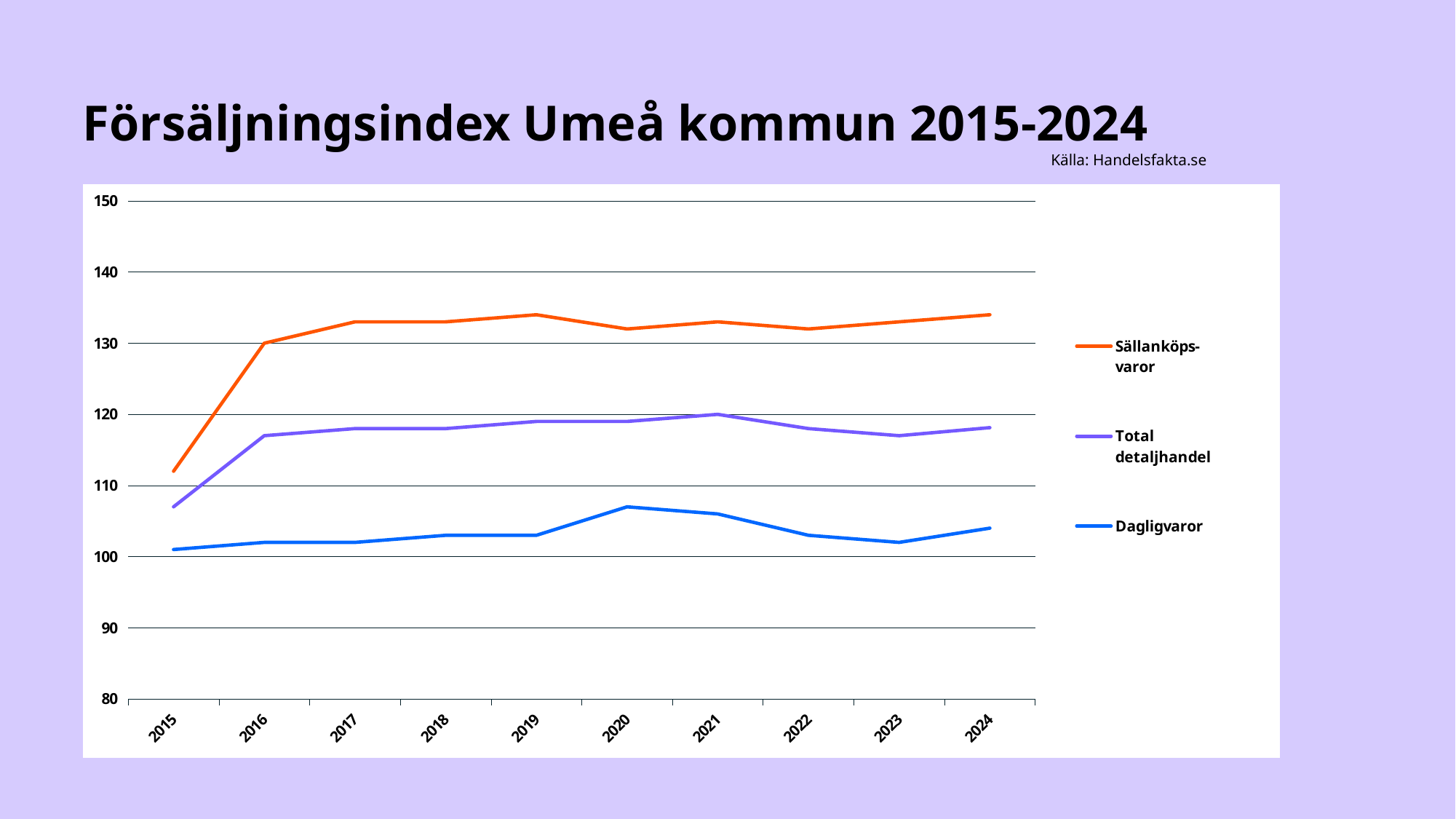
Which series has the lowest values across the whole period? Dagligvaror How many years are plotted along the x axis? 10 Is the value for Sällanköpsvaror in 2024 greater or less than 130? greater What kind of chart is shown on the slide? line chart Which series has the highest values across the whole period? Sällanköpsvaror Is the value for Dagligvaror in 2020 greater or less than 110? less What is the title of the chart? Försäljningsindex Umeå kommun 2015-2024 Is the value for Total detaljhandel in 2015 greater or less than 110? less Which is larger in 2023: Total detaljhandel or Dagligvaror? Total detaljhandel How many series does the legend list? 3 Does the Sällanköpsvaror line rise or fall between 2015 and 2016? rise